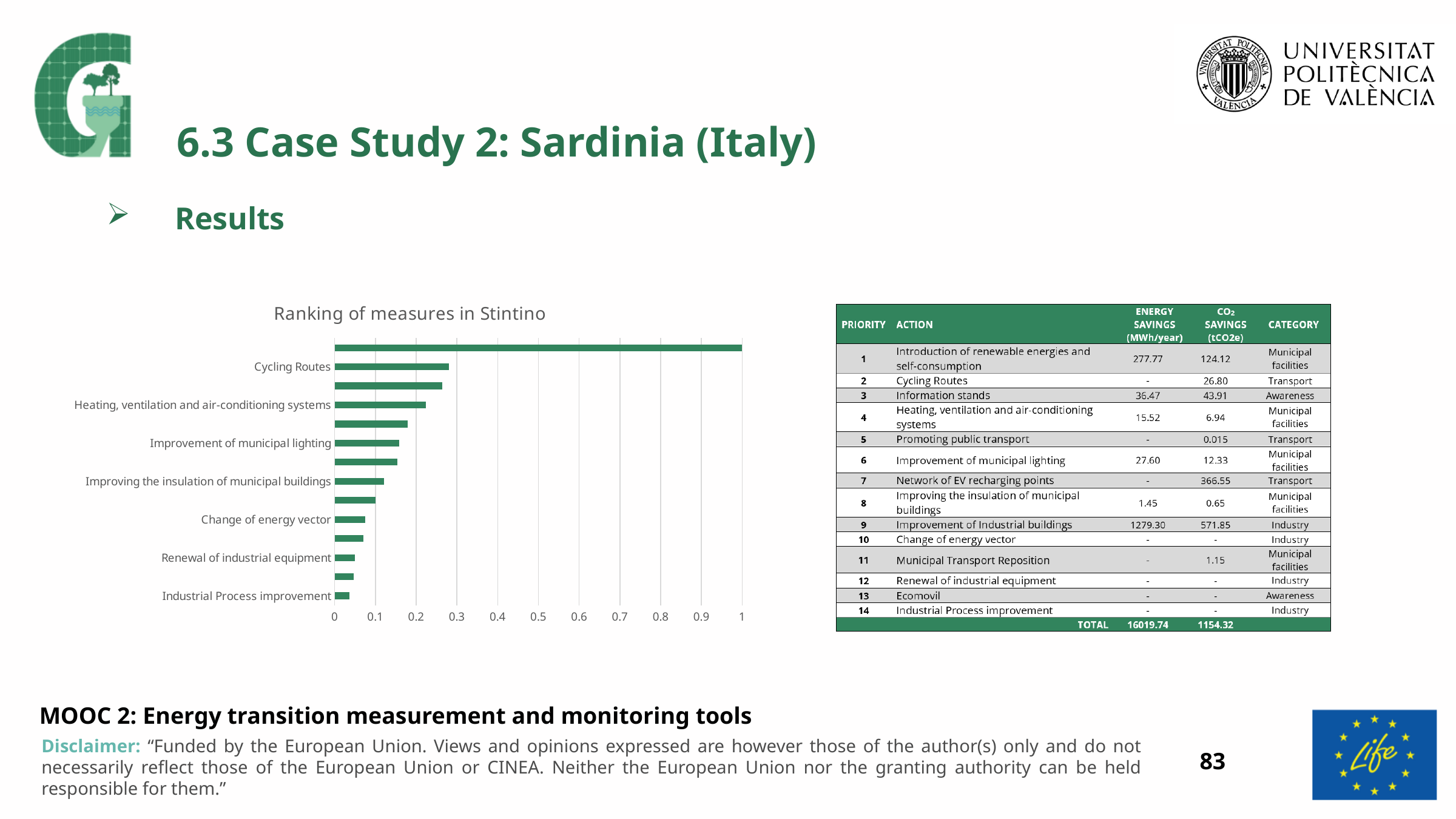
How many bars does the chart 'Ranking of measures in Stintino' contain? 14 In the chart 'Ranking of measures in Stintino', do the bar values increase or decrease from the top of the chart to the bottom? decrease What kind of chart is shown on the slide? bar chart In the chart 'Ranking of measures in Stintino', which of the labelled measures has the highest value? Cycling Routes What is the title of the chart on the slide? Ranking of measures in Stintino In the chart 'Ranking of measures in Stintino', which of the labelled measures has the lowest value? Industrial Process improvement In the chart 'Ranking of measures in Stintino', is the value for Industrial Process improvement greater or less than 0.1? less In the chart 'Ranking of measures in Stintino', is the value for Cycling Routes greater or less than 0.2? greater In the chart 'Ranking of measures in Stintino', is the value for Change of energy vector greater or less than 0.1? less In the chart 'Ranking of measures in Stintino', which has the larger value: Cycling Routes or Improvement of municipal lighting? Cycling Routes